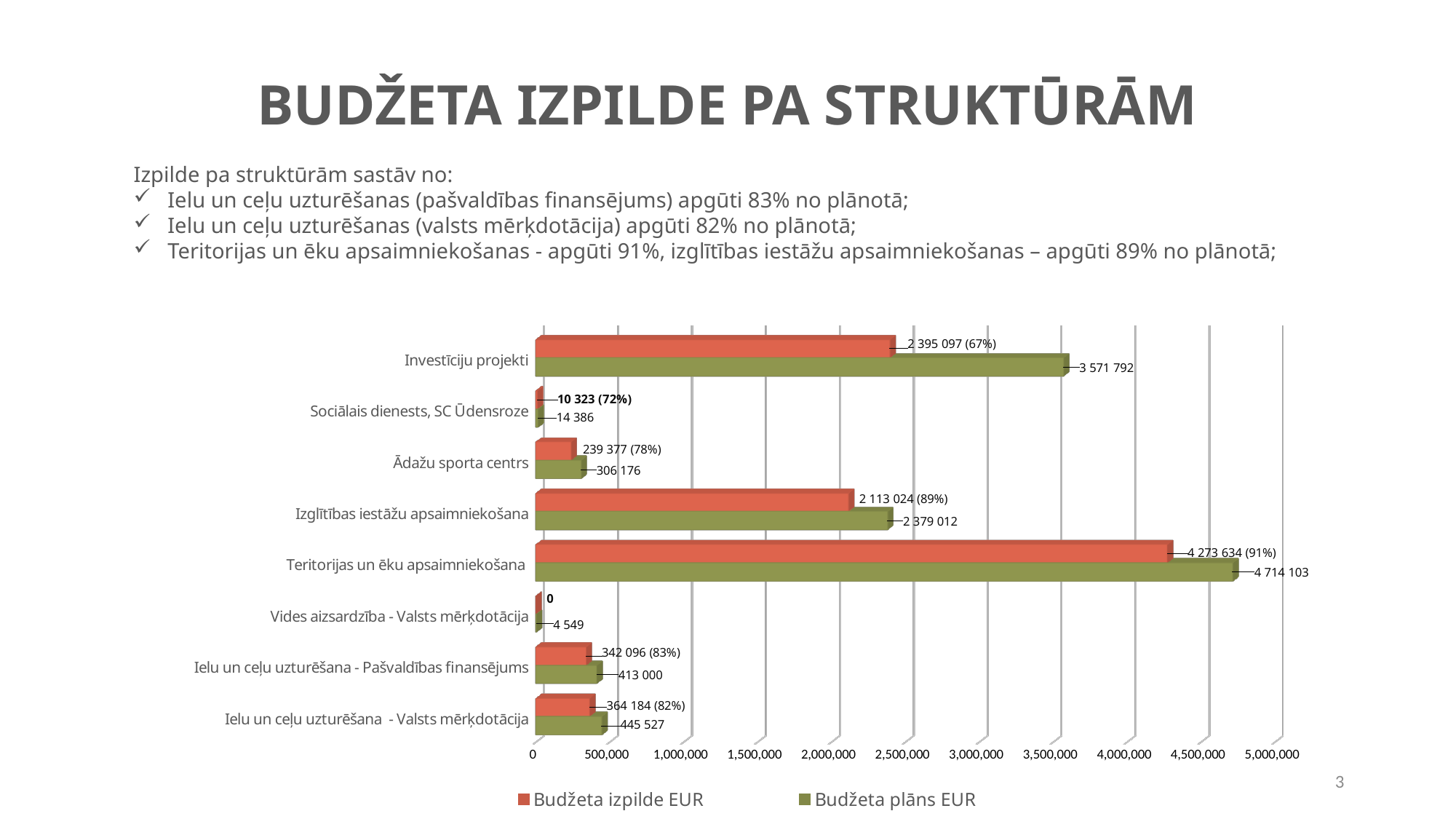
What is the Budžeta plāns EUR value for Investīciju projekti? 3 571 792 What is the Budžeta plāns EUR value for Ādažu sporta centrs? 306 176 What is the Budžeta izpilde EUR value for Teritorijas un ēku apsaimniekošana? 4 273 634 (91%) What type of chart is shown on the slide? Bar chart Which category has the lowest Budžeta plāns EUR value? Vides aizsardzība - Valsts mērķdotācija What is the difference between the Budžeta plāns EUR and Budžeta izpilde EUR values for Teritorijas un ēku apsaimniekošana? 440 469 What is the Budžeta izpilde EUR value for Vides aizsardzība - Valsts mērķdotācija? 0 How many categories are shown on the chart? 8 How many series does the legend list? 2 Which is larger: the Budžeta izpilde EUR value for Ielu un ceļu uzturēšana - Valsts mērķdotācija or for Ielu un ceļu uzturēšana - Pašvaldības finansējums? Ielu un ceļu uzturēšana - Valsts mērķdotācija Which category has the highest Budžeta plāns EUR value? Teritorijas un ēku apsaimniekošana Which colour represents the Budžeta plāns EUR series? Green